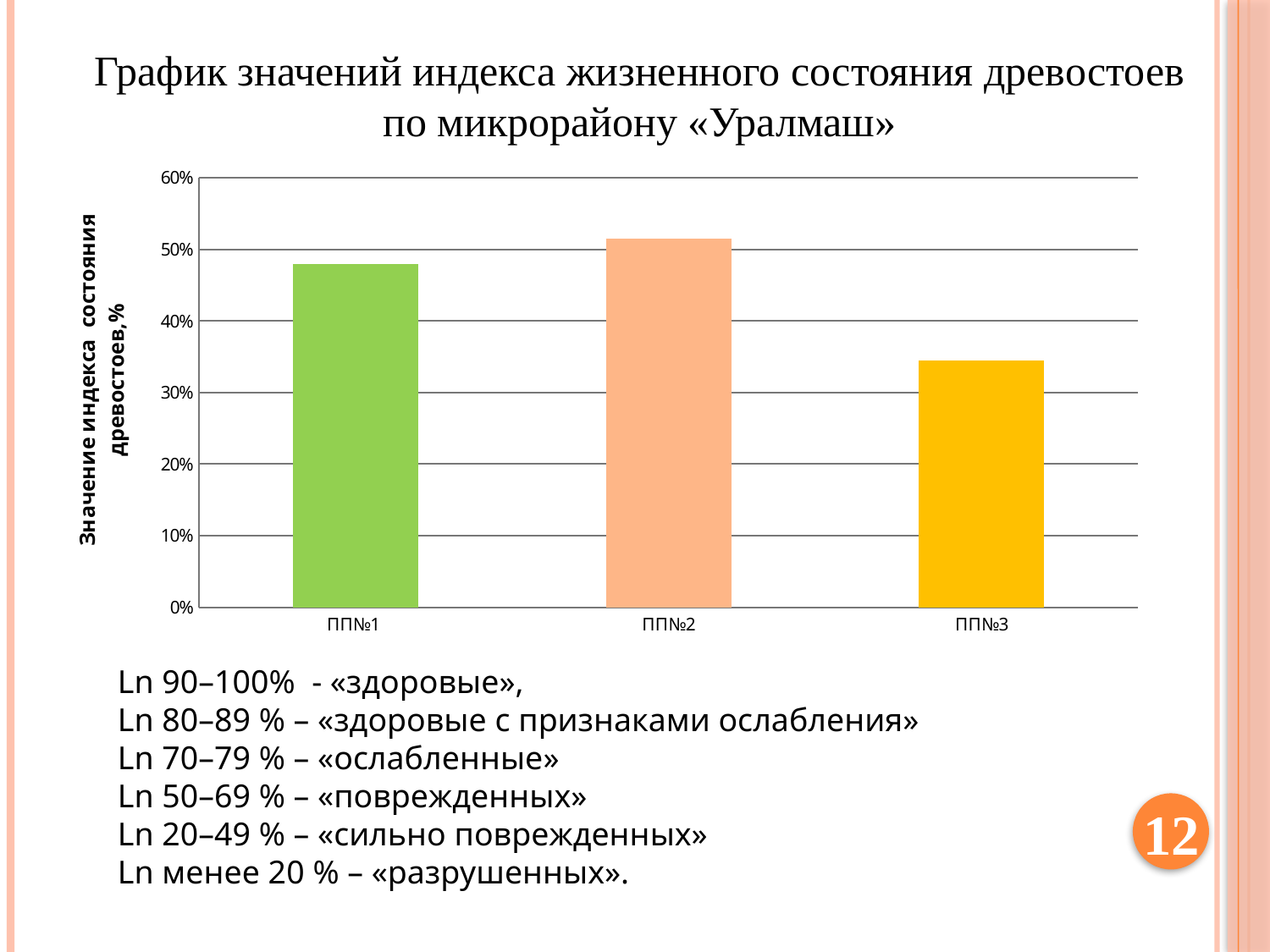
Is the value for ПП№3 greater or less than 40%? less Which is larger, the value for ПП№1 or the value for ПП№3? ПП№1 What is the maximum value shown on the vertical axis of the chart? 60% Is the value for ПП№1 greater or less than 50%? less Which is larger, the value for ПП№2 or the value for ПП№1? ПП№2 What kind of chart is shown on the slide? bar chart Which category has the highest value on the chart? ПП№2 Which category has the lowest value on the chart? ПП№3 What colour is the bar for ПП№1? green Is the value for ПП№3 greater or less than 30%? greater How many categories (bars) are plotted on the chart? 3